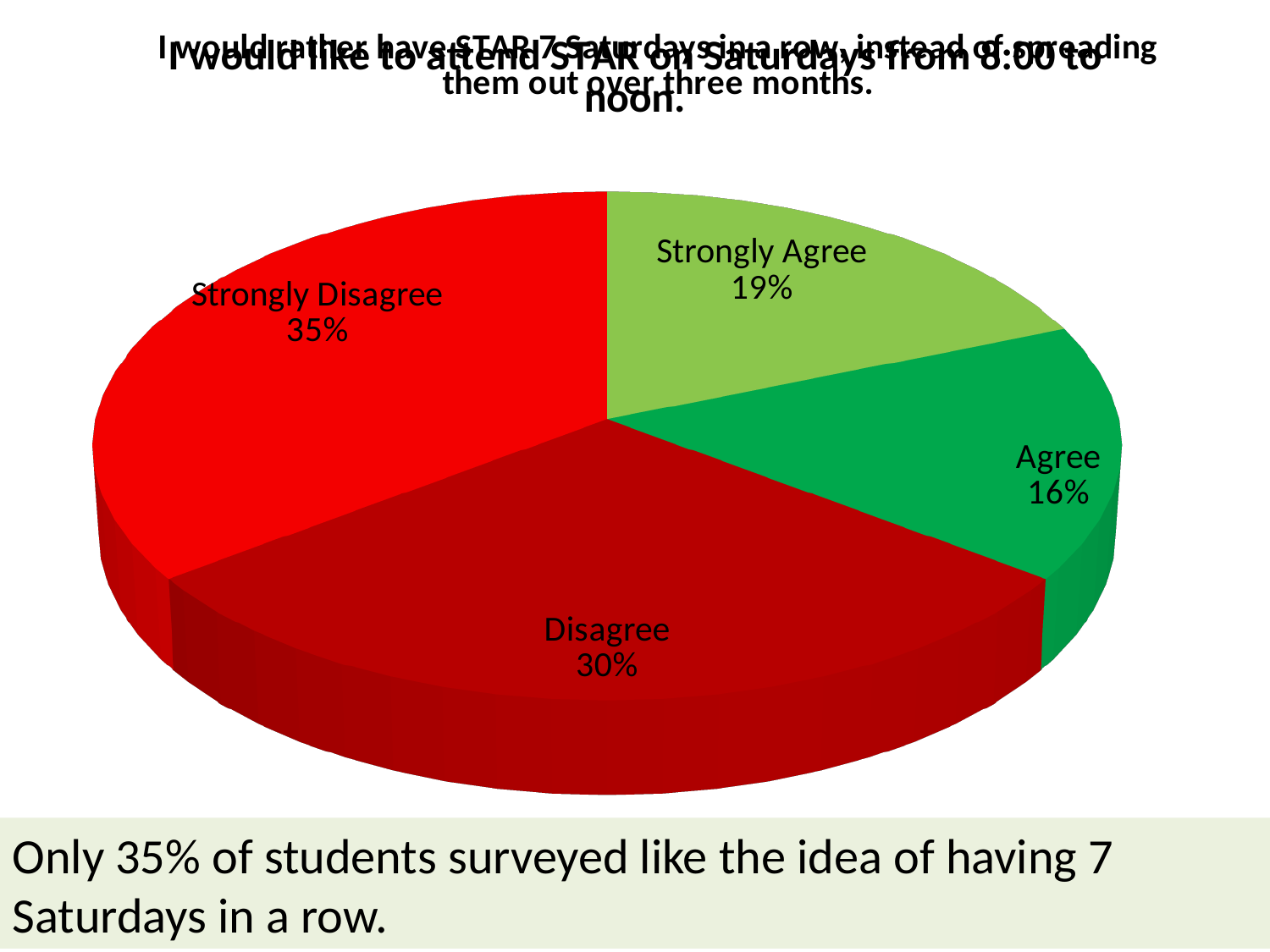
What is the difference in percentage points between Strongly Disagree and Disagree? 5 What kind of chart is shown on the slide? Pie chart What is the difference in percentage points between Strongly Agree and Agree? 3 Which is larger, the share for Disagree or the share for Strongly Agree? Disagree What colour is the Strongly Disagree slice? Red Which response has the largest share of the pie? Strongly Disagree What percentage of respondents chose Strongly Agree? 19% What percentage of respondents chose Agree? 16% What percentage of respondents chose Strongly Disagree? 35% What percentage of respondents chose Disagree? 30% Which response has the smallest share of the pie? Agree How many slices does the pie chart have? 4